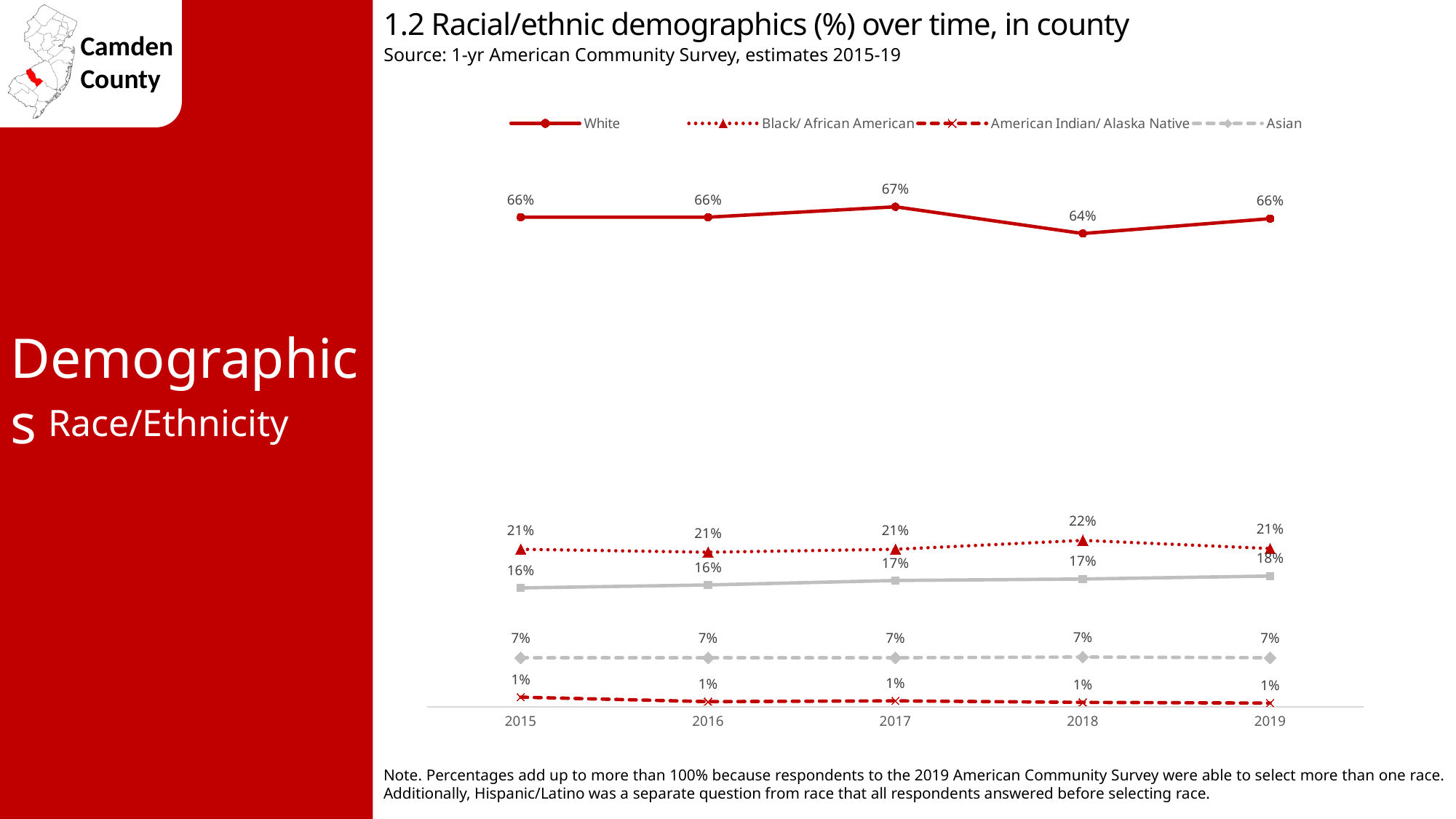
What is the value for Black/ African American in 2018? 22% What is the value for American Indian/ Alaska Native in 2019? 1% How many years are shown along the x axis? 5 How many series does the legend list? 4 Does the Asian series rise, fall, or stay flat from 2015 to 2019? Stays flat In which year is the White series at its highest? 2017 What is the difference between the White value in 2017 and the White value in 2018? 3% What type of chart is shown on the slide? Line chart What is the value for Asian in 2017? 7% What is the value for White in 2018? 64% Which is larger in 2019, the value for Black/ African American or the value for Asian? Black/ African American In which year is the White series at its lowest? 2018